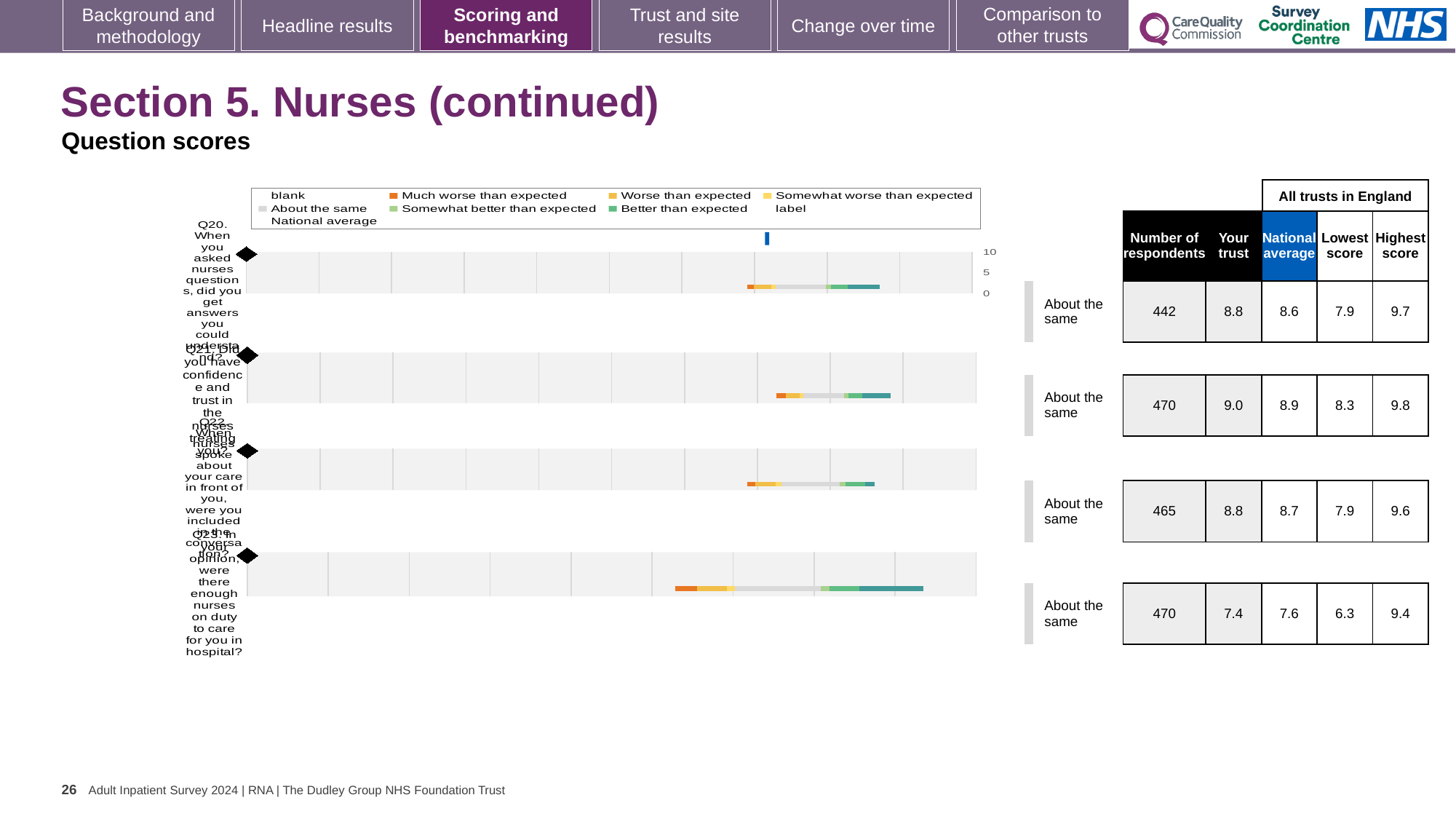
What kind of chart is used to show the question scores on this slide? bar chart What is the national average score for Q21 (did you have confidence and trust in the nurses treating you)? 8.9 Which question has the highest 'Your trust' score? Q21 What is the lowest score among all trusts in England for Q23 (were there enough nurses on duty to care for you in hospital)? 6.3 What is the highest score among all trusts in England for Q21? 9.8 How many questions (rows) are plotted in the chart? 4 For Q20, which is larger: the 'Your trust' score or the national average? Your trust What benchmark category is shown for Q23? About the same For Q23, what is the difference between the highest score and the lowest score among all trusts in England? 3.1 How many respondents answered Q22 (when nurses spoke about your care in front of you, were you included in the conversation)? 465 Which question has the lowest 'Your trust' score? Q23 What is the 'Your trust' score for Q20 (when you asked nurses questions, did you get answers you could understand)? 8.8